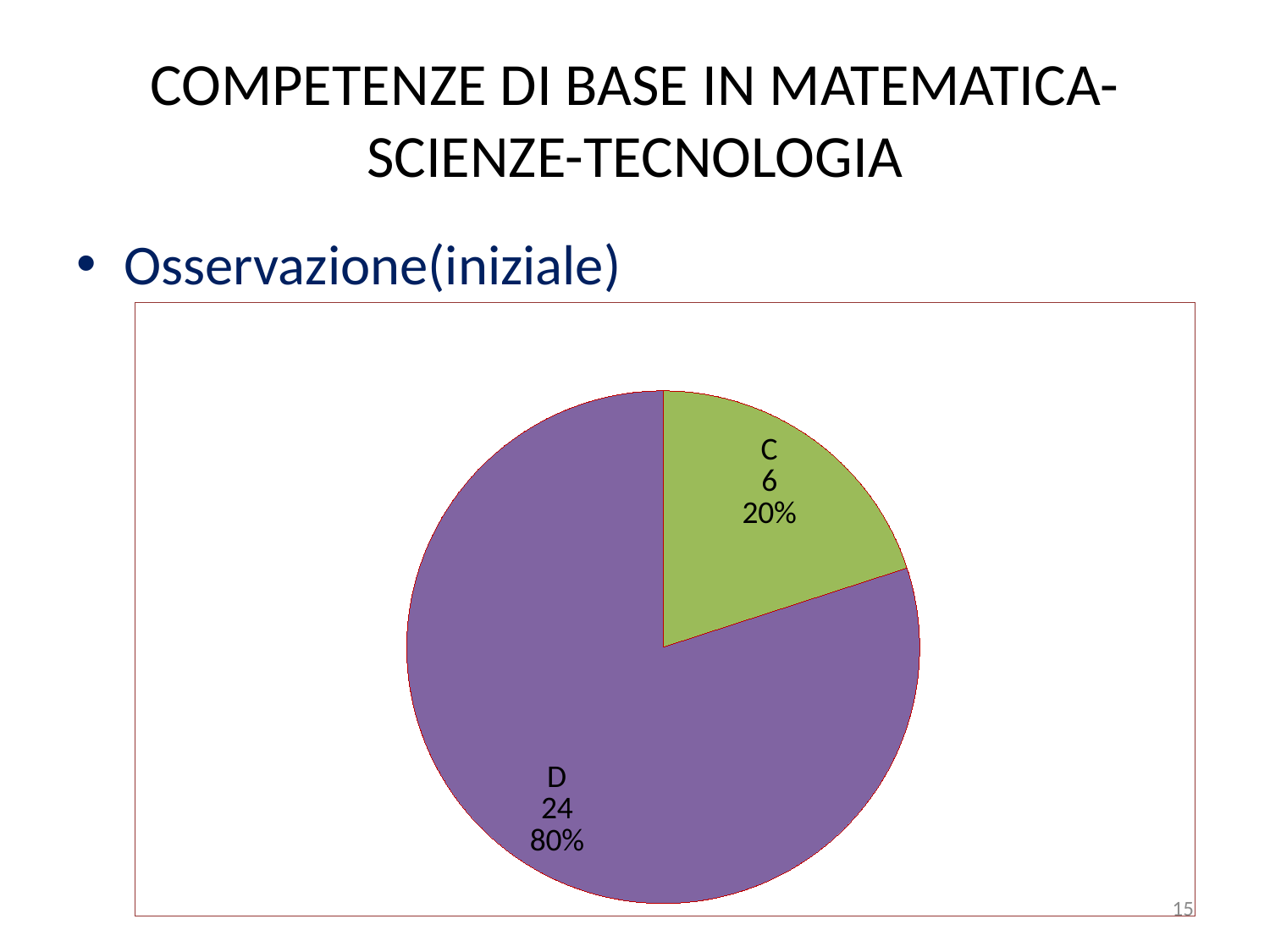
Which is larger, the value for C or the value for D? D What kind of chart is shown on the slide? pie chart How many slices does the pie chart have? 2 What is the total of the values shown in the pie chart? 30 What is the difference between the values for D and C? 18 What is the value for category D? 24 Which category has the largest slice? D Which category has the smallest slice? C What colour is the slice for category C? green What share of the pie does slice C represent? 20% What is the value for category C? 6 What share of the pie does slice D represent? 80%